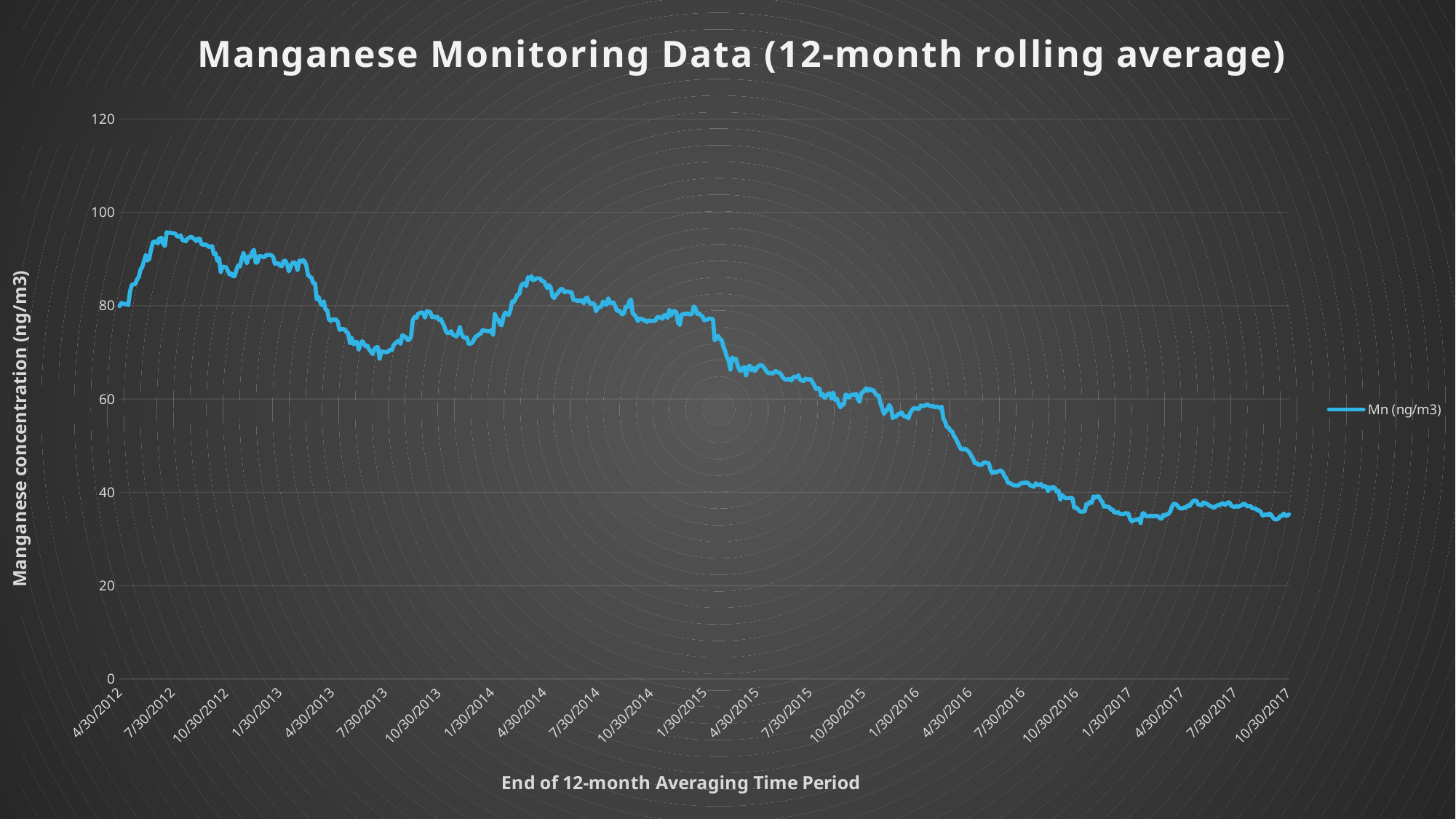
Is the value for 1/30/2017 greater or less than 40? less Is the value for 7/30/2012 greater or less than 80? greater What kind of chart is shown on the slide? line chart What is the title of the chart? Manganese Monitoring Data (12-month rolling average) Is the value for 7/30/2013 greater or less than 80? less Overall, do the values rise or fall from 4/30/2012 to 10/30/2017? fall How many series does the legend list? 1 What is the label on the y axis? Manganese concentration (ng/m3)